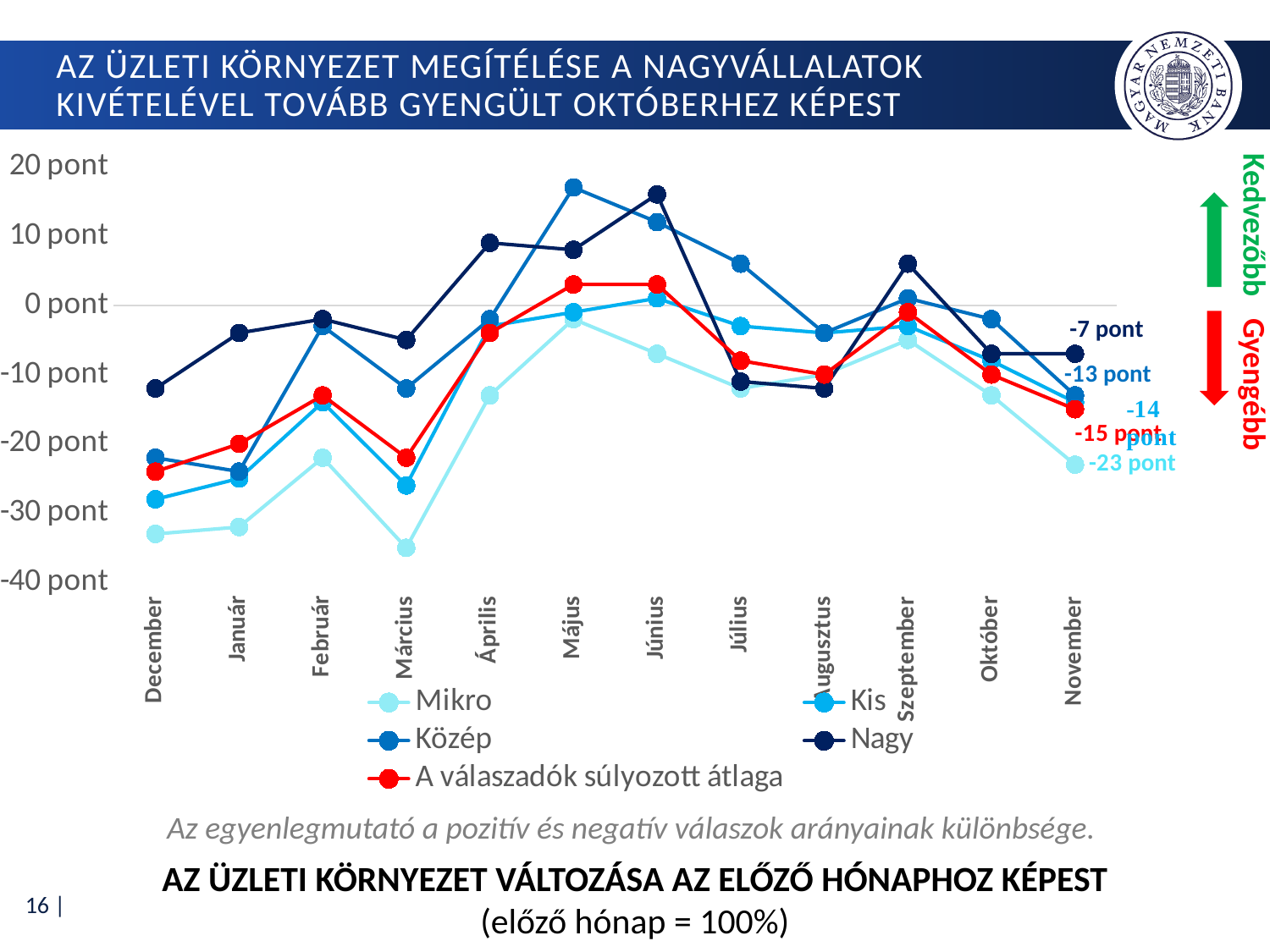
In November, which is larger: the value for Kis or the value for Közép? Közép Is the value for Mikro in Március greater or less than -30 pont? less What is the value for A válaszadók súlyozott átlaga in November? -15 pont How many series does the legend list? 5 Which series has the lowest value in November? Mikro What is the value for Mikro in November? -23 pont What is the value for Nagy in November? -7 pont How many months are shown on the x axis? 12 Is the value for Közép in Május greater or less than 10 pont? greater Which series has the highest value in November? Nagy What is the value for Közép in November? -13 pont What is the difference between the November values of Nagy and Mikro? 16 pont